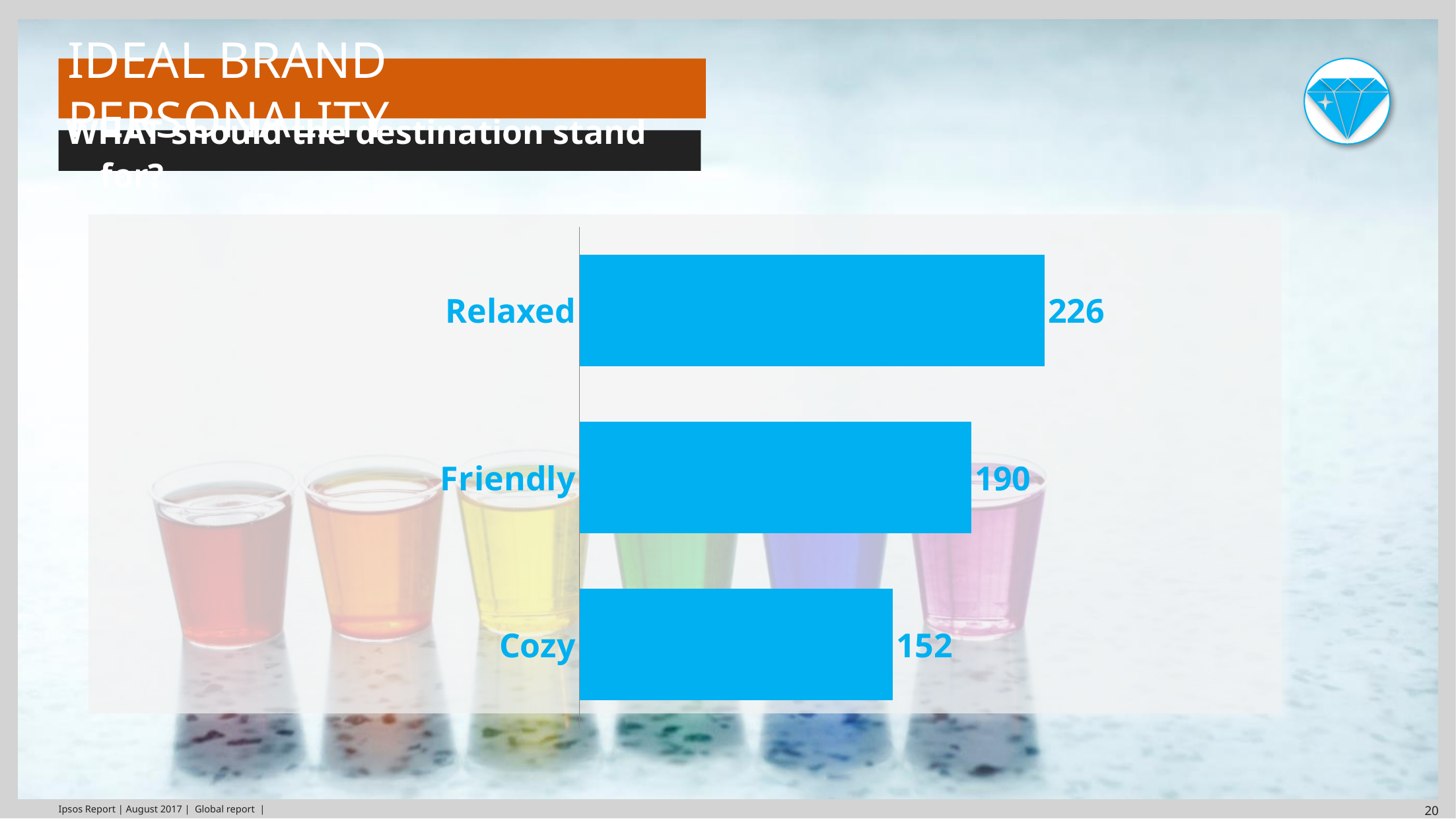
What is the value for Friendly? 190 What is the difference between the values for Relaxed and Cozy? 74 Which category has the lowest value? Cozy What is the value for Relaxed? 226 How many categories are shown in the chart? 3 What is the difference between the values for Relaxed and Friendly? 36 Which is larger, the value for Friendly or the value for Cozy? Friendly What colour are the bars in the chart? Blue What kind of chart is shown on the slide? Bar chart Which category has the highest value? Relaxed What is the value for Cozy? 152 What is the difference between the values for Friendly and Cozy? 38